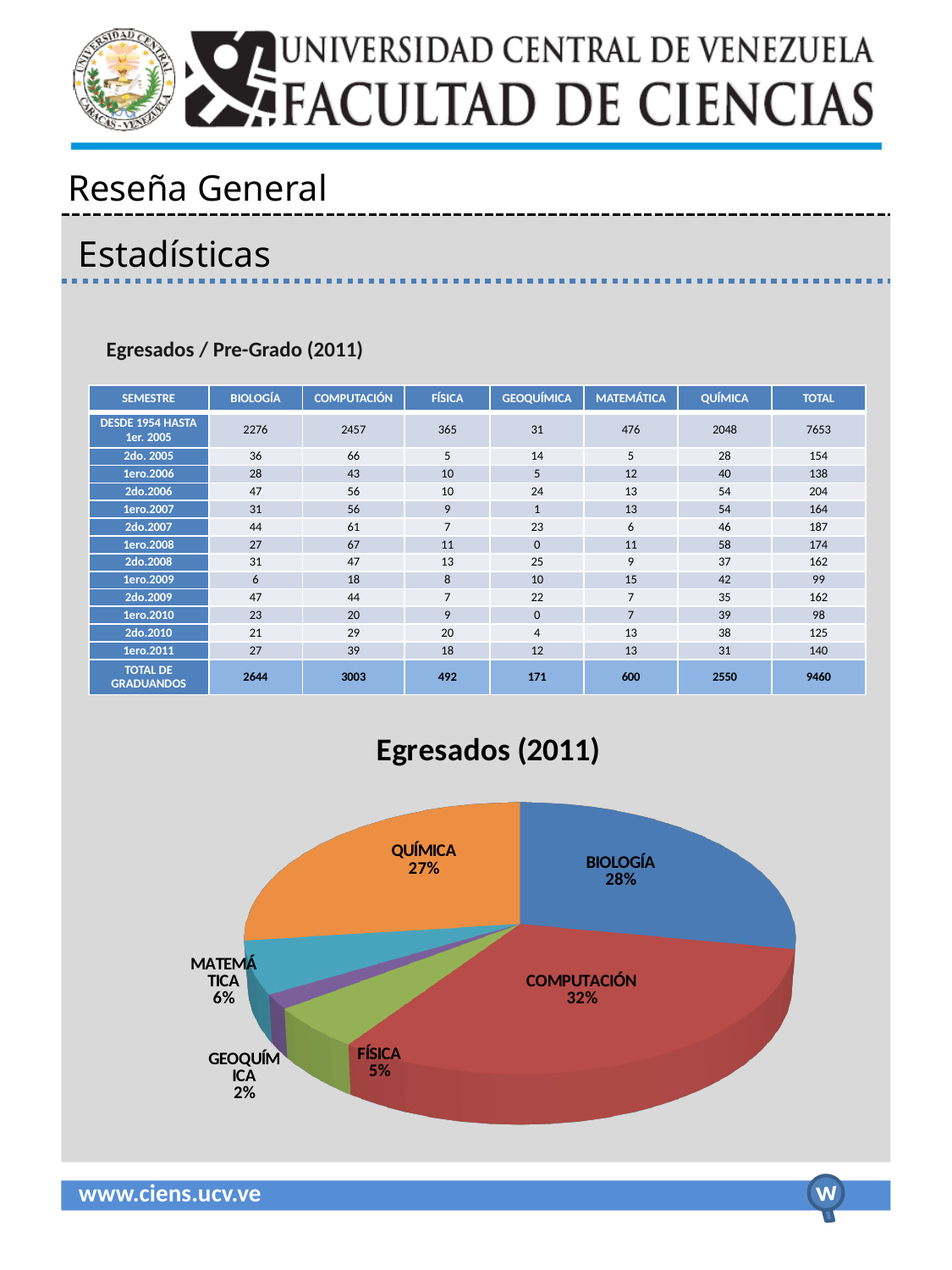
What is the difference in percentage points between COMPUTACIÓN and QUÍMICA in the pie chart? 5 Which category has the smallest slice of the pie chart? GEOQUÍMICA What is the title of the chart on the slide? Egresados (2011) What percentage is shown for QUÍMICA in the pie chart? 27% What percentage is shown for GEOQUÍMICA in the pie chart? 2% What percentage is shown for BIOLOGÍA in the pie chart? 28% What kind of chart is shown under the title "Egresados (2011)"? pie chart What is the combined share of MATEMÁTICA and FÍSICA in the pie chart? 11% Which category has the largest slice of the pie chart? COMPUTACIÓN What share of the pie does COMPUTACIÓN represent? 32% How many slices does the pie chart have? 6 Which slice is larger in the pie chart, MATEMÁTICA or FÍSICA? MATEMÁTICA